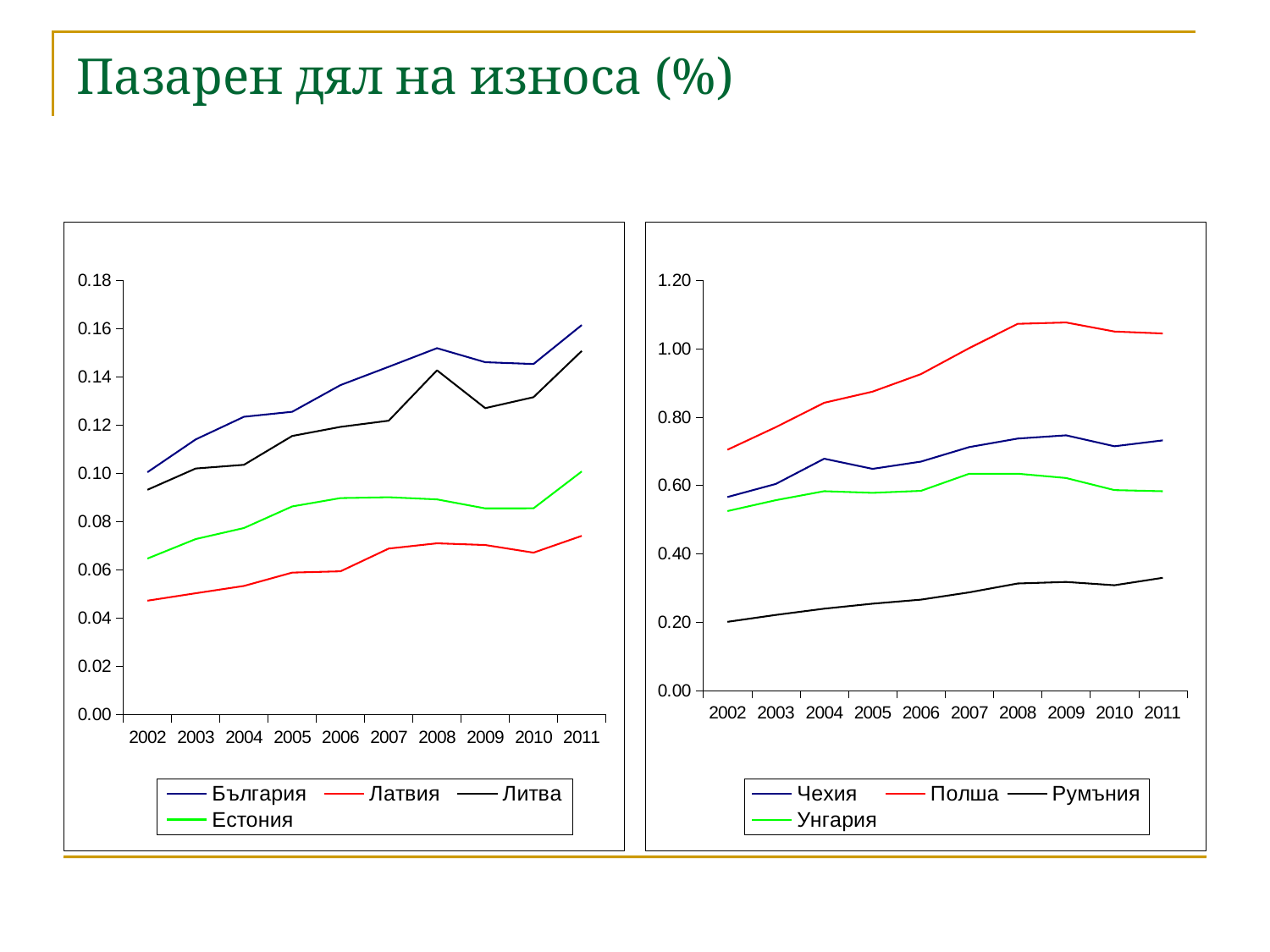
What kind of chart is the left chart on the slide? line chart In the right chart, does the value for Румъния rise or fall from 2002 to 2011? rise How many years are shown on the x axis of the right chart? 10 In the left chart, is the value for България in 2011 greater or less than 0.14? greater In the right chart, is the value for Румъния in 2011 greater or less than 0.40? less In the left chart, which series has the lowest value in 2002? Латвия How many series does the legend of the right chart list? 4 In the left chart, which series has the highest value in 2011? България In the right chart, which series has the lowest value in 2011? Румъния In the right chart, is the value for Полша in 2008 greater or less than 1.00? greater In the right chart, which series has the highest value in 2008? Полша How many series does the legend of the left chart list? 4